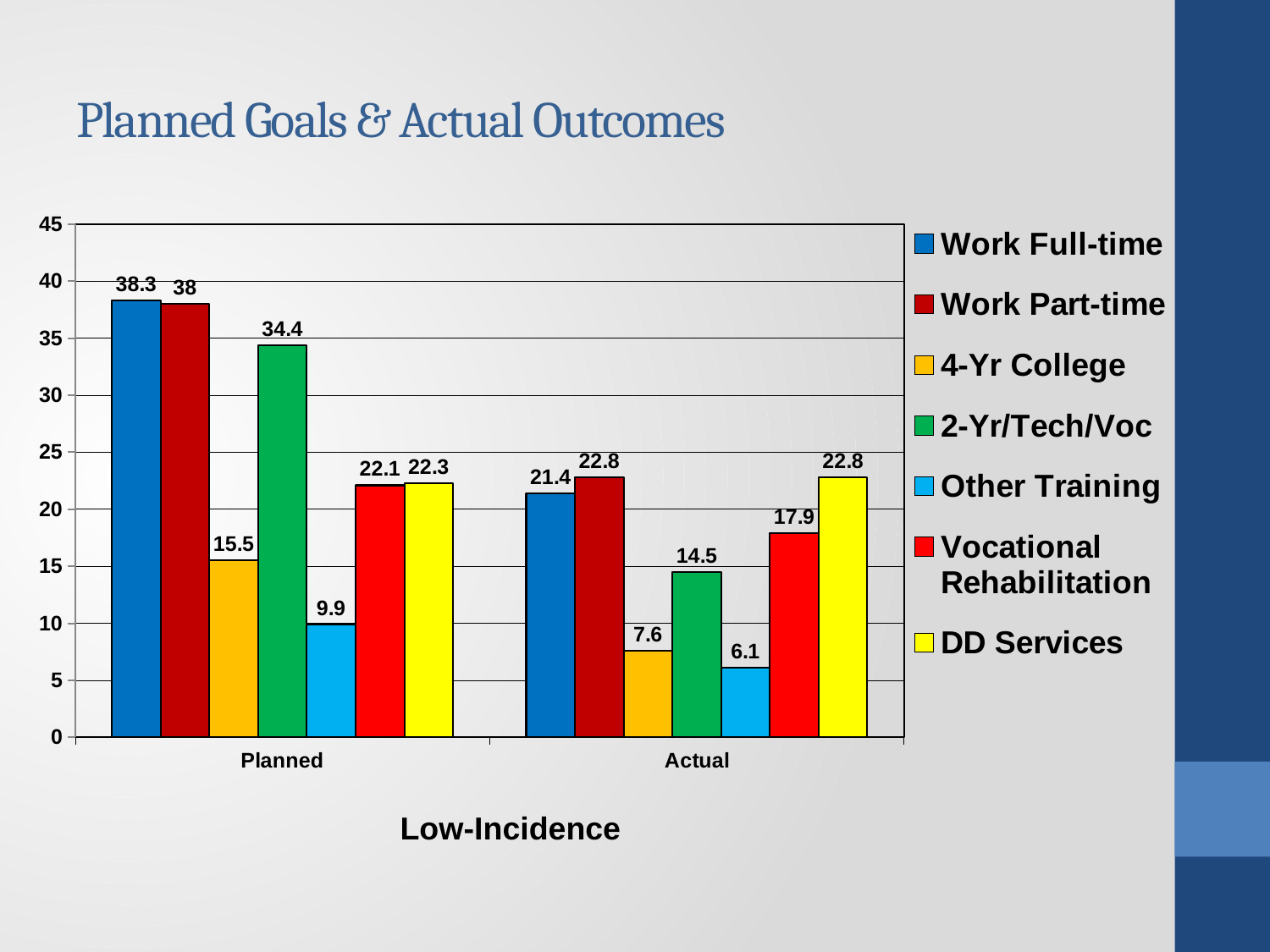
Which series has the lowest Actual value? Other Training What is the Actual value for Other Training? 6.1 What is the Planned value for DD Services? 22.3 What kind of chart is shown on the slide? Bar chart What is the label shown below the x axis of the chart? Low-Incidence How many categories are shown on the x axis? 2 Which series has the highest Planned value? Work Full-time What is the Planned value for Work Full-time? 38.3 How many series does the legend list? 7 What is the difference between the Planned and Actual values for 4-Yr College? 7.9 Which is larger: the Planned value for 2-Yr/Tech/Voc or the Planned value for Vocational Rehabilitation? 2-Yr/Tech/Voc What is the Actual value for 2-Yr/Tech/Voc? 14.5